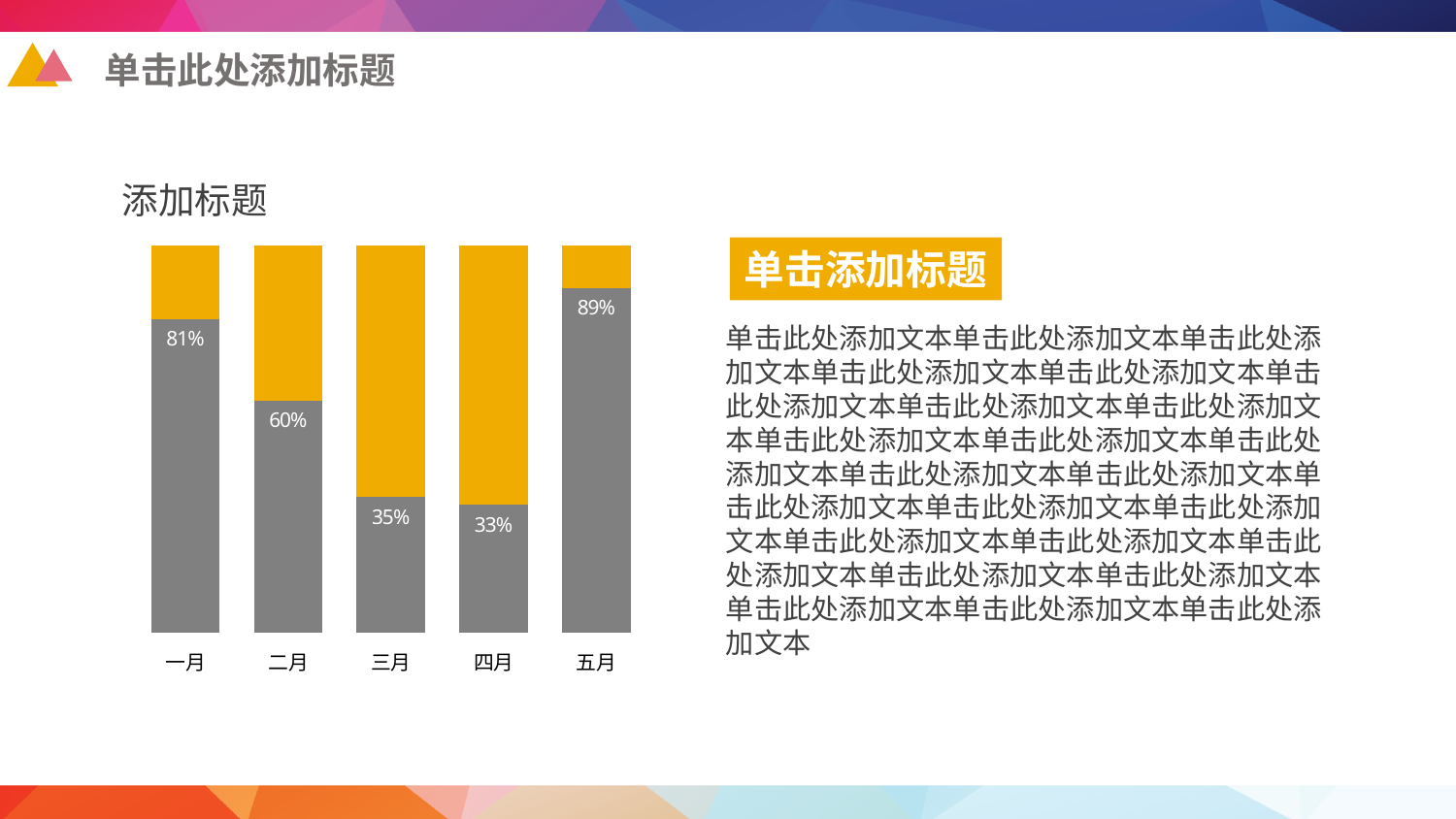
What is the labelled value for 五月 in the chart? 89% What is the labelled value for 三月 in the chart? 35% Which has the larger labelled value, 一月 or 五月? 五月 How many months are shown on the x axis of the chart? 5 What is the labelled value for 四月 in the chart? 33% What is the title shown above the chart? 添加标题 Which month has the highest labelled value in the chart? 五月 What kind of chart is shown on the slide? Stacked bar chart What is the labelled value for 一月 in the chart? 81% What is the labelled value for 二月 in the chart? 60% Which month has the lowest labelled value in the chart? 四月 What is the difference between the labelled values for 一月 and 二月? 21%